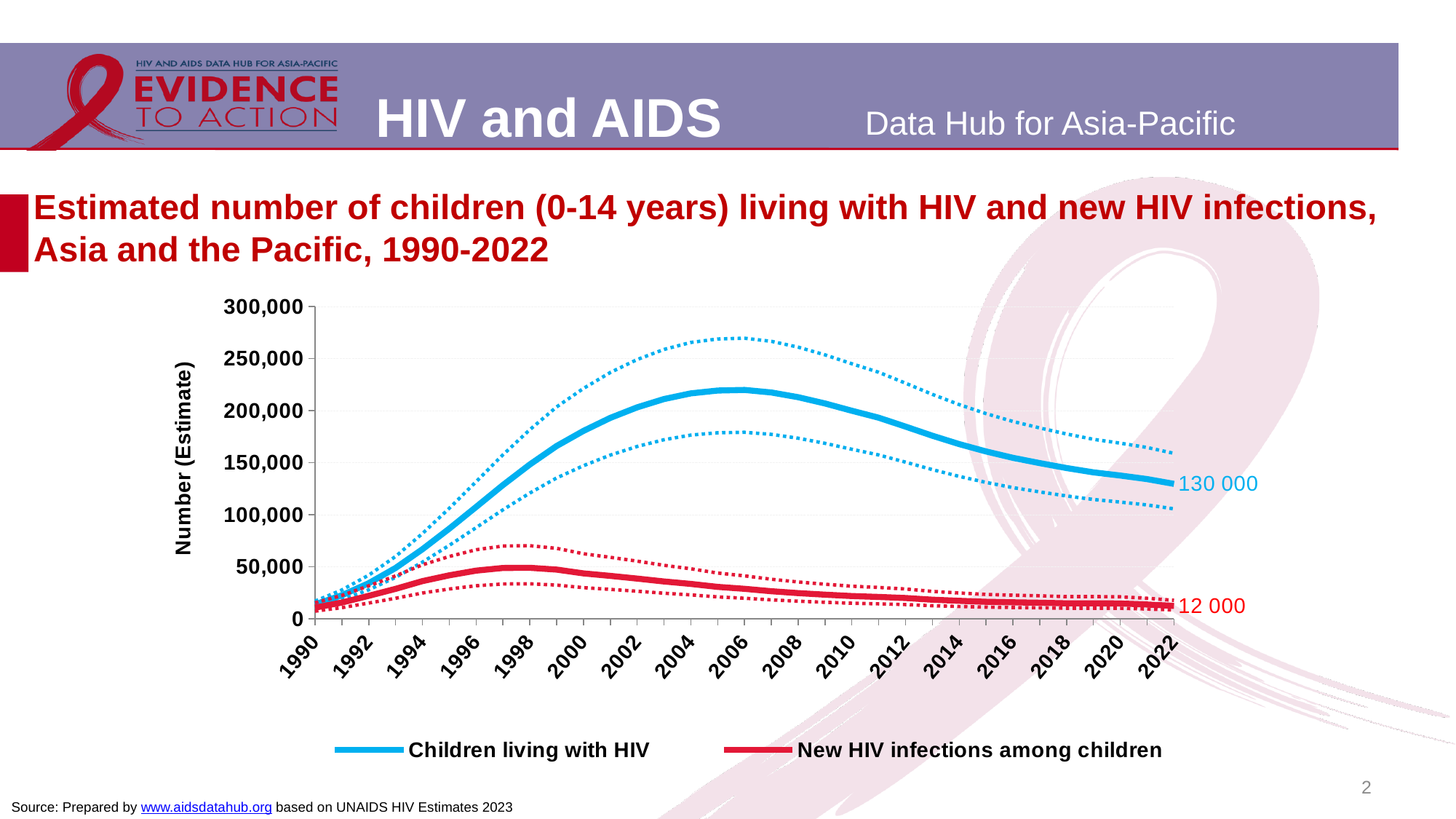
Does the number of new HIV infections among children rise or fall between 1990 and 1998? Rise How many series does the legend list? 2 Does the number of children living with HIV rise or fall between 2006 and 2022? Fall Is the value for new HIV infections among children in 1998 greater or less than 100,000? less What kind of chart is shown on the slide? Line chart What is the difference between the number of children living with HIV and the number of new HIV infections among children in 2022? 118 000 What is the title of the vertical axis? Number (Estimate) What is the estimated number of new HIV infections among children in 2022? 12 000 In 2022, which is larger: children living with HIV or new HIV infections among children? Children living with HIV What is the estimated number of children living with HIV in 2022? 130 000 Is the value for children living with HIV in 1990 greater or less than 50,000? less Is the value for children living with HIV in 2006 greater or less than 200,000? greater